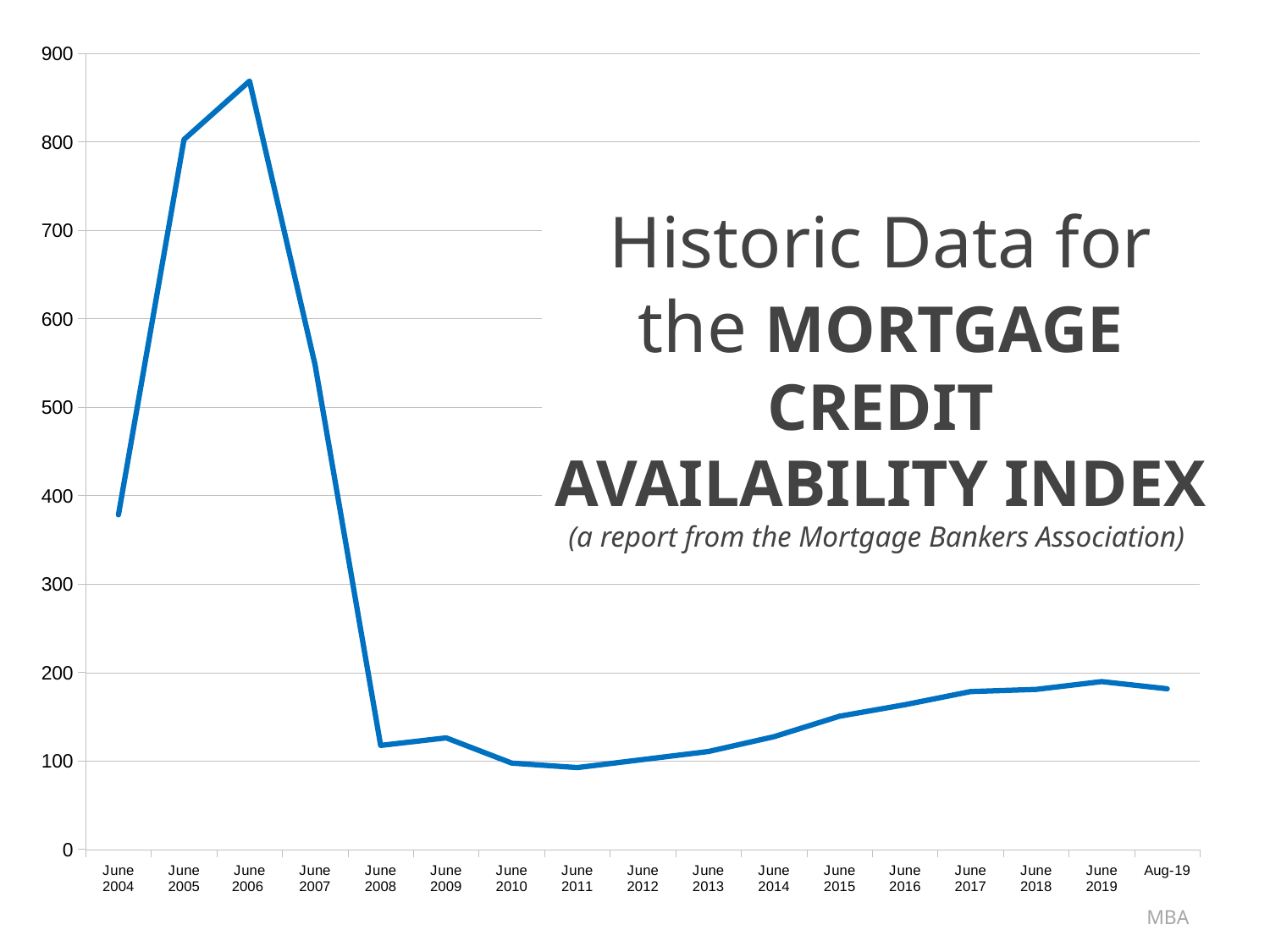
Is the value for June 2004 greater or less than 400? less Which point on the x axis has the highest value? June 2006 What is the title of the chart on the slide? Historic Data for the MORTGAGE CREDIT AVAILABILITY INDEX Is the value for June 2005 greater or less than 700? greater How many data points are plotted along the x axis? 17 Which is larger, the value for June 2005 or the value for June 2007? June 2005 Do the values rise or fall from June 2011 to June 2019? rise Which is larger, the value for June 2010 or the value for June 2015? June 2015 What kind of chart is shown on the slide? line chart Is the value for June 2007 greater or less than 500? greater